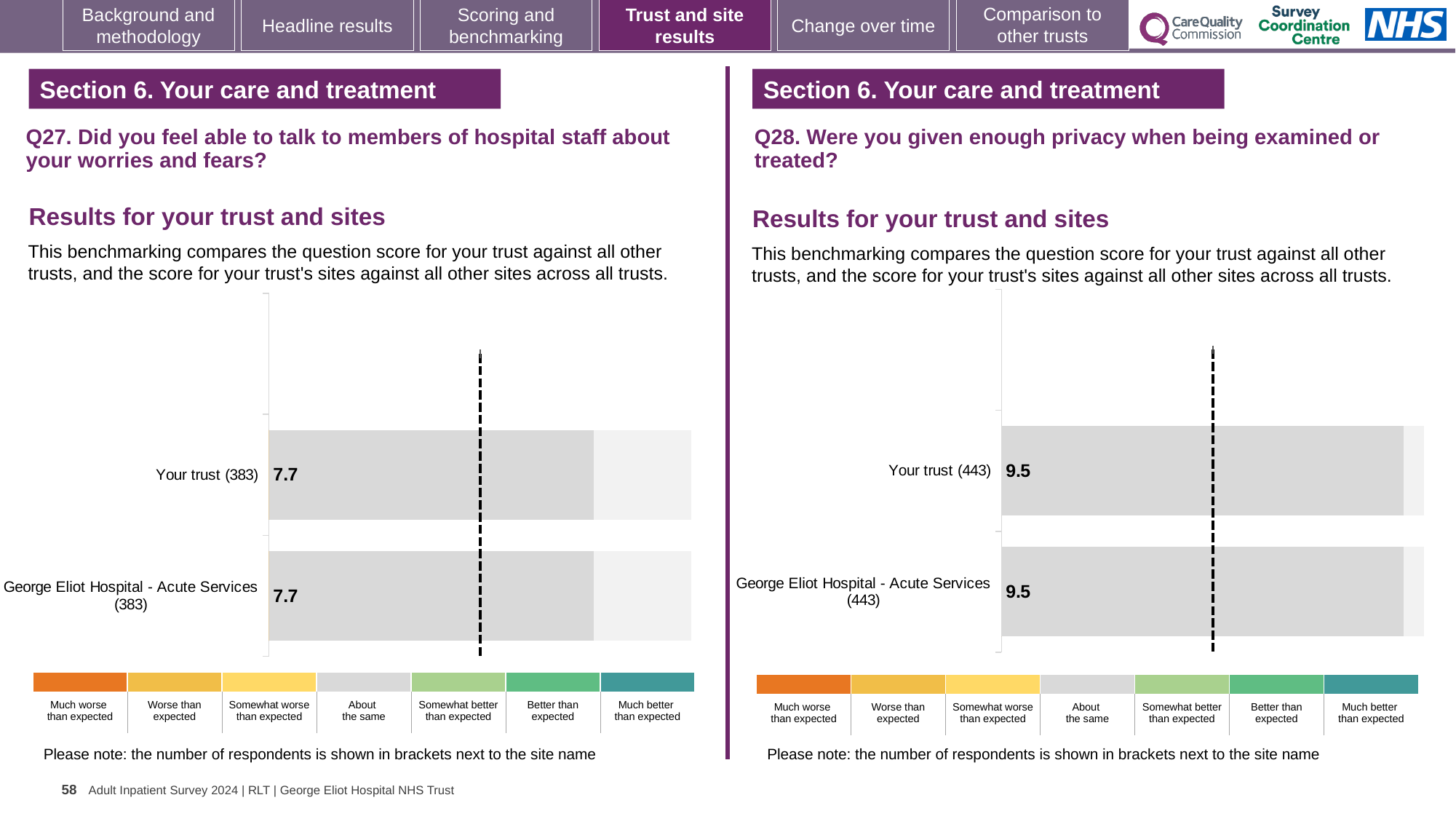
Is the score for Your trust on the Q28 chart (right) larger or smaller than the score for Your trust on the Q27 chart (left)? Larger On the Q28 chart (right), how many respondents are shown in brackets for George Eliot Hospital - Acute Services? 443 On the Q27 chart (left), what is the score for Your trust? 7.7 How many bars are plotted on the Q28 chart (right)? 2 What kind of chart is used for the Q27 results (left)? Bar chart On the Q27 chart (left), what is the difference between the score for Your trust and the score for George Eliot Hospital - Acute Services? 0 On the Q28 chart (right), what is the score for George Eliot Hospital - Acute Services? 9.5 On the Q27 chart (left), how many respondents are shown in brackets for Your trust? 383 On the Q27 chart (left), what is the score for George Eliot Hospital - Acute Services? 7.7 How many bars are plotted on the Q27 chart (left)? 2 On the Q28 chart (right), what is the score for Your trust? 9.5 On the Q28 chart (right), what is the difference between the score for Your trust and the score for George Eliot Hospital - Acute Services? 0